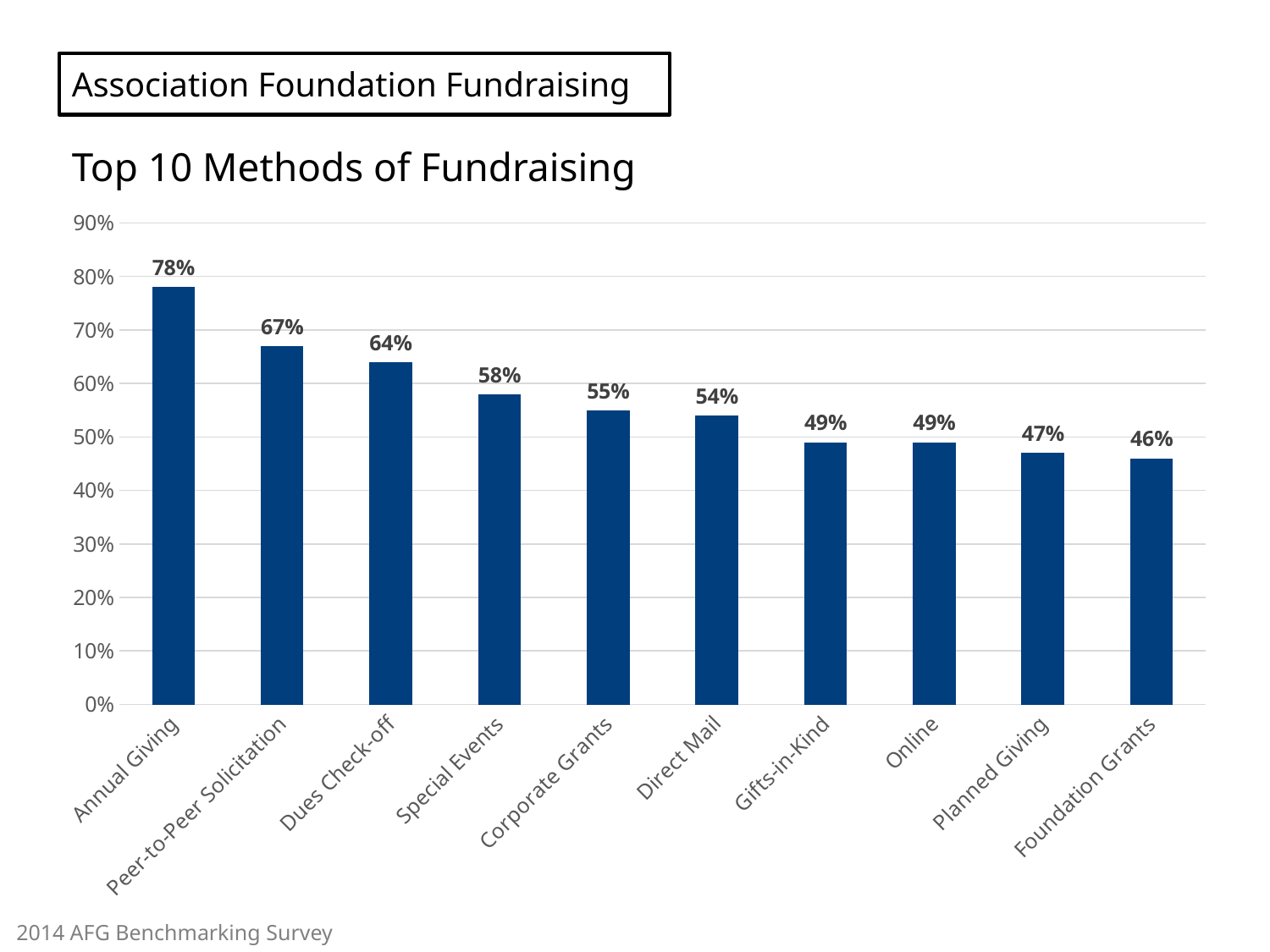
What is the value for Direct Mail? 54% Is the value for Special Events greater or less than 50%? greater Which fundraising method has the lowest value? Foundation Grants What is the title of the chart? Top 10 Methods of Fundraising What kind of chart is shown on the slide? Bar chart Which fundraising method has the highest value? Annual Giving Which is larger, the value for Corporate Grants or the value for Online? Corporate Grants What is the value for Annual Giving? 78% What is the difference between the values for Annual Giving and Peer-to-Peer Solicitation? 11% What is the value for Planned Giving? 47% What is the difference between the values for Dues Check-off and Special Events? 6% How many fundraising methods are shown in the chart? 10